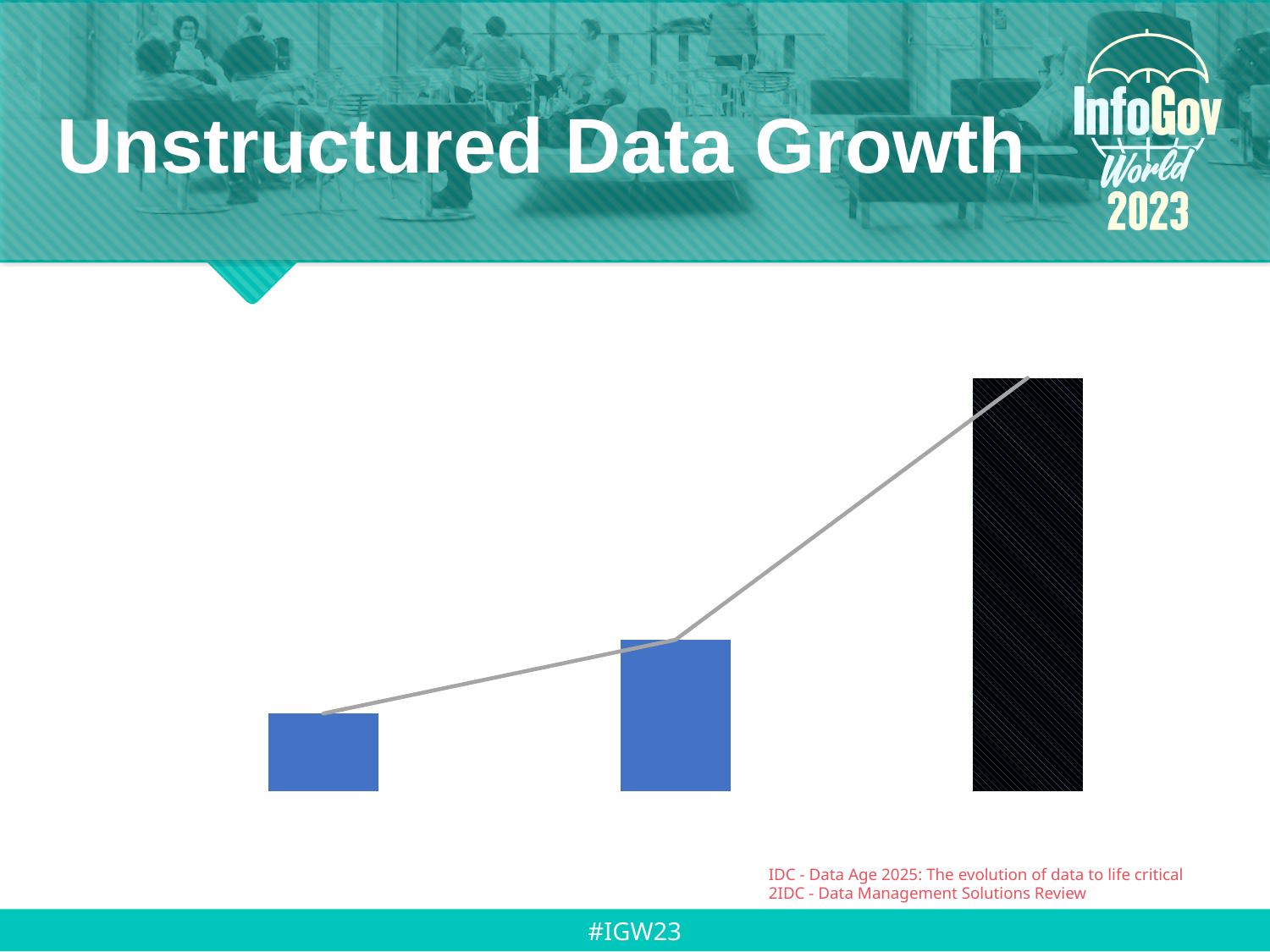
Do the bar values rise or fall from left to right across the chart? rise Which is taller, the rightmost bar or the middle bar? the rightmost bar How many bars does the chart show? 3 What kind of chart is shown on the slide? combination bar and line chart What is the title of the slide containing the chart? Unstructured Data Growth What colour is the rightmost bar in the chart? black Which bar is the tallest in the chart? the rightmost bar Which is taller, the middle bar or the leftmost bar? the middle bar Which bar is the shortest in the chart? the leftmost bar